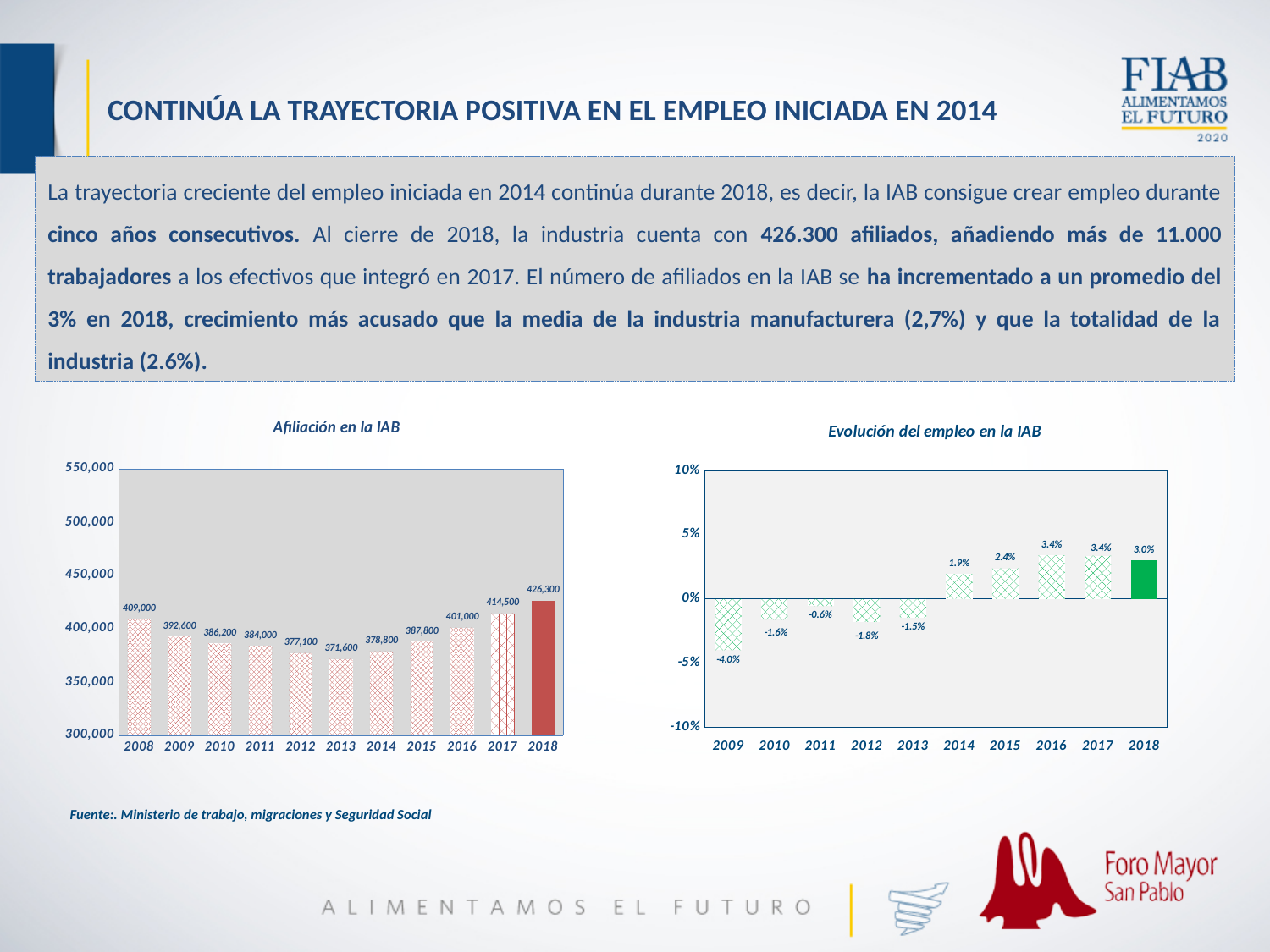
In the 'Evolución del empleo en la IAB' chart, what is the value for 2018? 3.0% In the 'Afiliación en la IAB' chart, which year has the highest value? 2018 In the 'Evolución del empleo en la IAB' chart, how many years are shown on the x axis? 10 In the 'Evolución del empleo en la IAB' chart, which year has the lowest value? 2009 In the 'Afiliación en la IAB' chart, which year has the lowest value? 2013 In the 'Afiliación en la IAB' chart, how many years are shown on the x axis? 11 In the 'Evolución del empleo en la IAB' chart, what is the value for 2009? -4.0% In the 'Afiliación en la IAB' chart, what is the value for 2018? 426,300 In the 'Afiliación en la IAB' chart, what is the difference between the 2018 and 2017 values? 11,800 In the 'Evolución del empleo en la IAB' chart, is the value for 2015 larger than the value for 2014? Yes, 2015 (2.4%) What kind of chart is 'Afiliación en la IAB'? Bar chart In the 'Afiliación en la IAB' chart, what is the value for 2013? 371,600